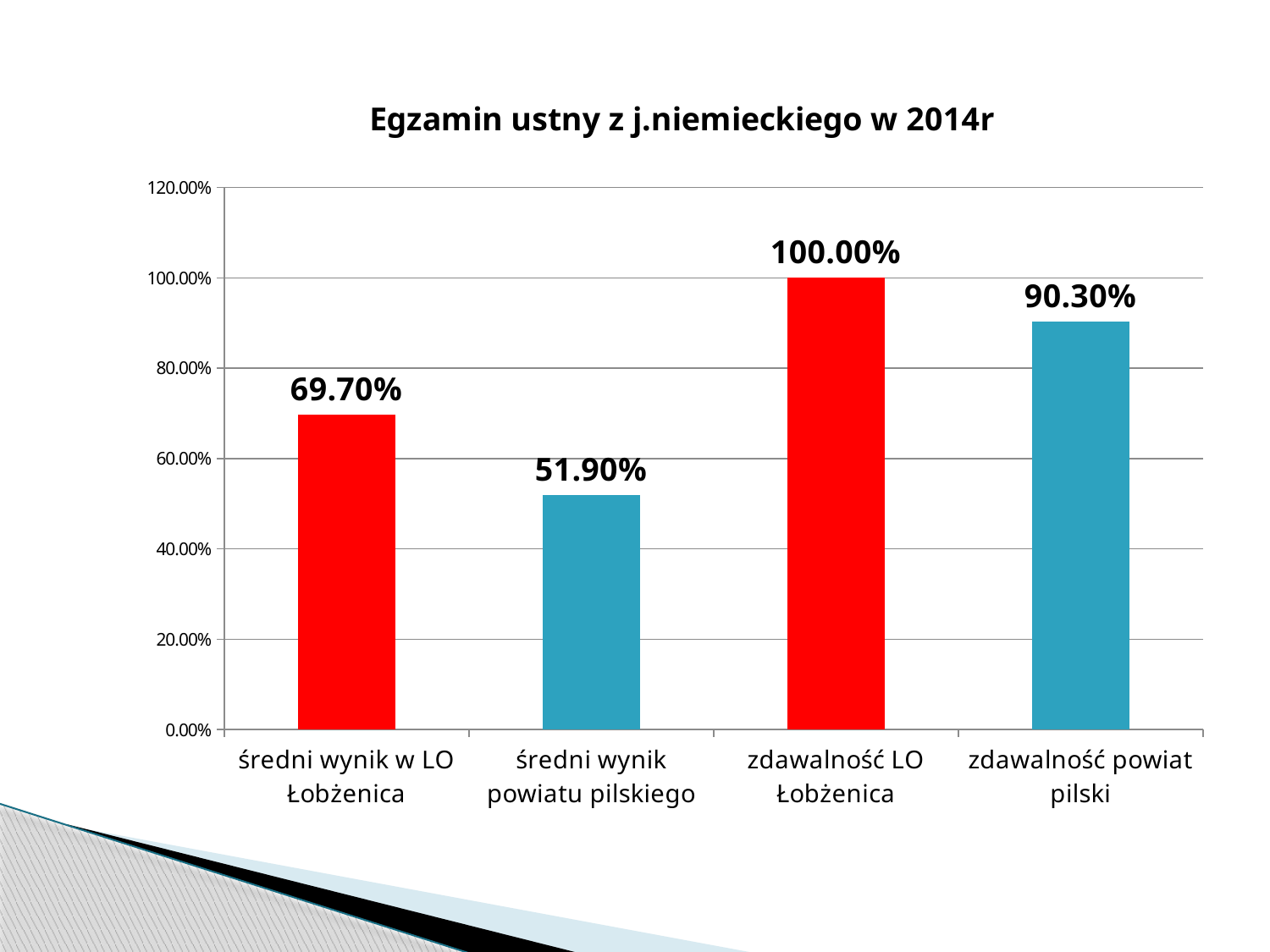
Which category has the highest value? zdawalność LO Łobżenica How many categories are shown in the chart? 4 What is the difference between "średni wynik w LO Łobżenica" and "średni wynik powiatu pilskiego"? 17.80% What is the difference between "zdawalność LO Łobżenica" and "zdawalność powiat pilski"? 9.70% Which is larger: "zdawalność powiat pilski" or "średni wynik w LO Łobżenica"? zdawalność powiat pilski What is the value for "średni wynik w LO Łobżenica"? 69.70% What is the value for "zdawalność LO Łobżenica"? 100.00% What is the value for "zdawalność powiat pilski"? 90.30% Which category has the lowest value? średni wynik powiatu pilskiego What kind of chart is this? bar chart What is the title of the chart? Egzamin ustny z j.niemieckiego w 2014r What is the value for "średni wynik powiatu pilskiego"? 51.90%